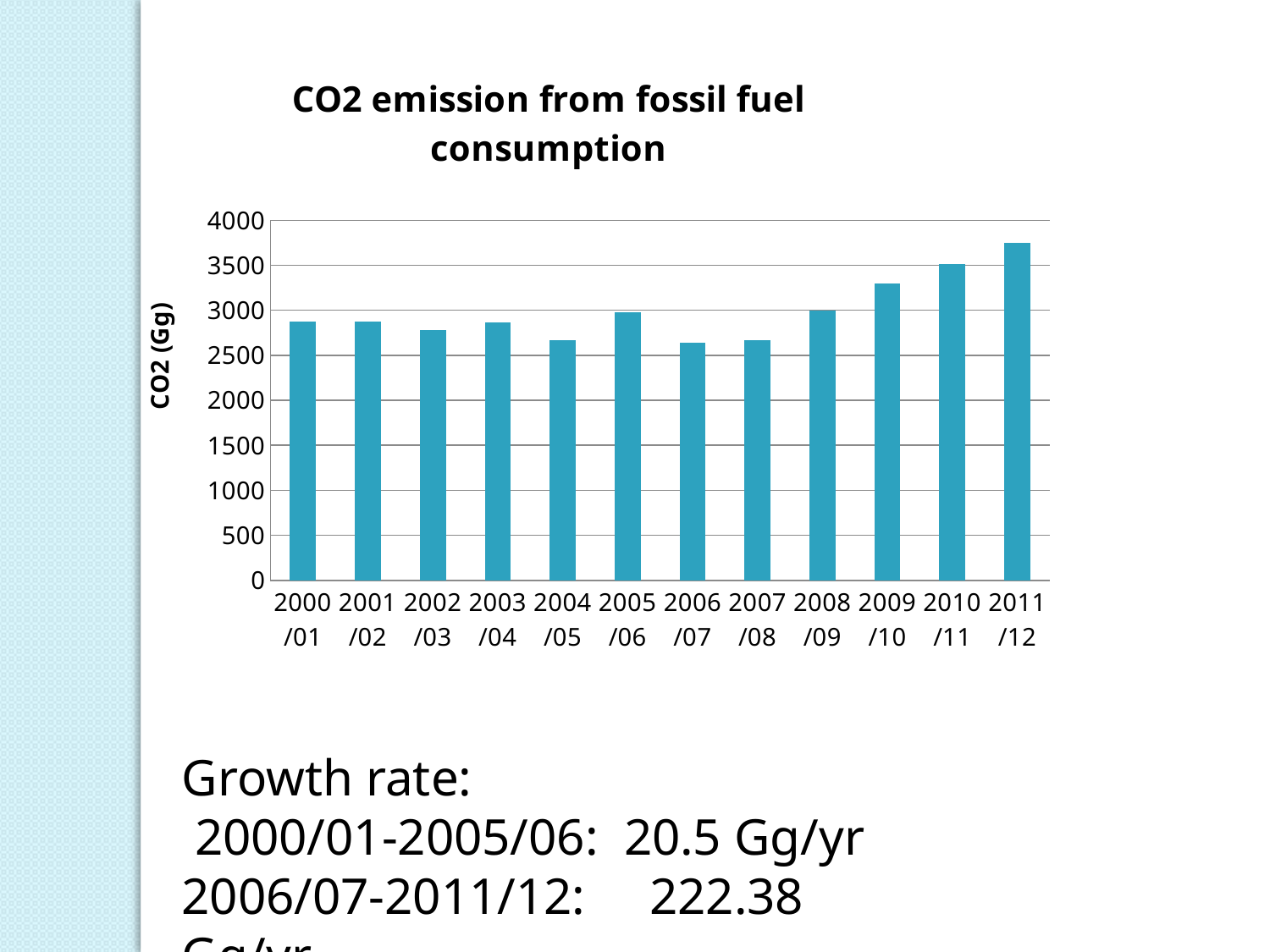
Is the CO2 emission for 2004/05 greater or less than 3000? less What type of chart is shown on the slide? Bar chart Which year has the higher CO2 emission, 2000/01 or 2011/12? 2011/12 Do CO2 emissions rise or fall from 2006/07 to 2011/12? Rise Is the CO2 emission for 2011/12 greater or less than 3500? greater What is the label on the vertical axis of the chart? CO2 (Gg) Is the CO2 emission for 2006/07 greater or less than 2500? greater Which year has the higher CO2 emission, 2005/06 or 2009/10? 2009/10 How many years (bars) are plotted in the chart? 12 Which year has the highest CO2 emission in the chart? 2011/12 What is the title of the chart? CO2 emission from fossil fuel consumption